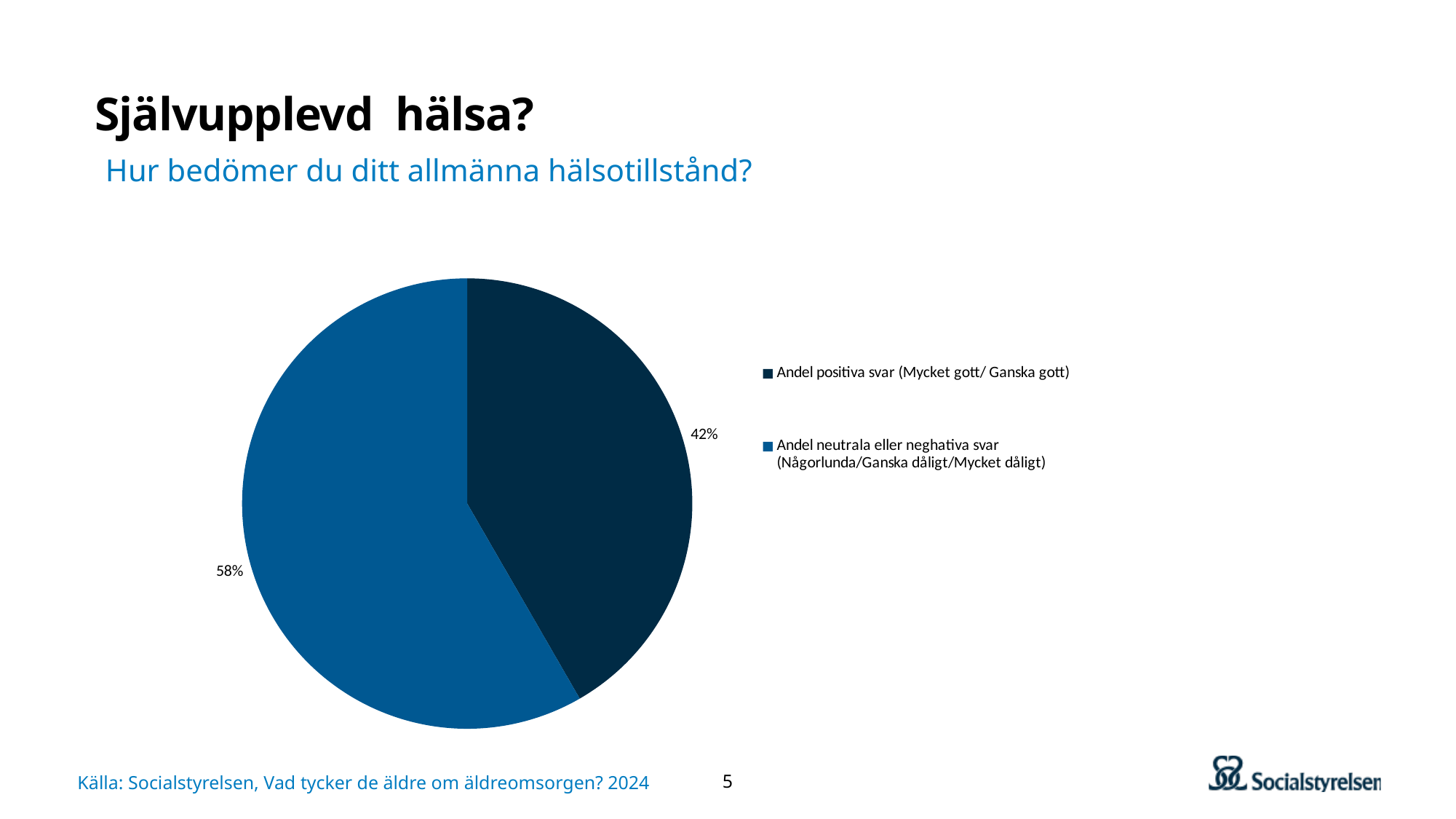
How many slices does the pie chart have? 2 Which slice of the pie is the largest? Andel neutrala eller neghativa svar (Någorlunda/Ganska dåligt/Mycket dåligt) What question is shown as the subtitle above the chart? Hur bedömer du ditt allmänna hälsotillstånd? What is the difference in percentage points between the neutral/negative slice and the positive slice? 16 percentage points What share of the pie is labelled 'Andel positiva svar (Mycket gott/ Ganska gott)'? 42% What share of the pie is labelled 'Andel neutrala eller neghativa svar (Någorlunda/Ganska dåligt/Mycket dåligt)'? 58% Which is larger: the share of positive answers or the share of neutral or negative answers? Andel neutrala eller neghativa svar What kind of chart is shown on the slide? Pie chart Is the share of positive answers greater or less than 50%? less Which legend entry is shown in the darker navy colour? Andel positiva svar (Mycket gott/ Ganska gott) Which slice of the pie is the smallest? Andel positiva svar (Mycket gott/ Ganska gott) How many entries does the legend list? 2